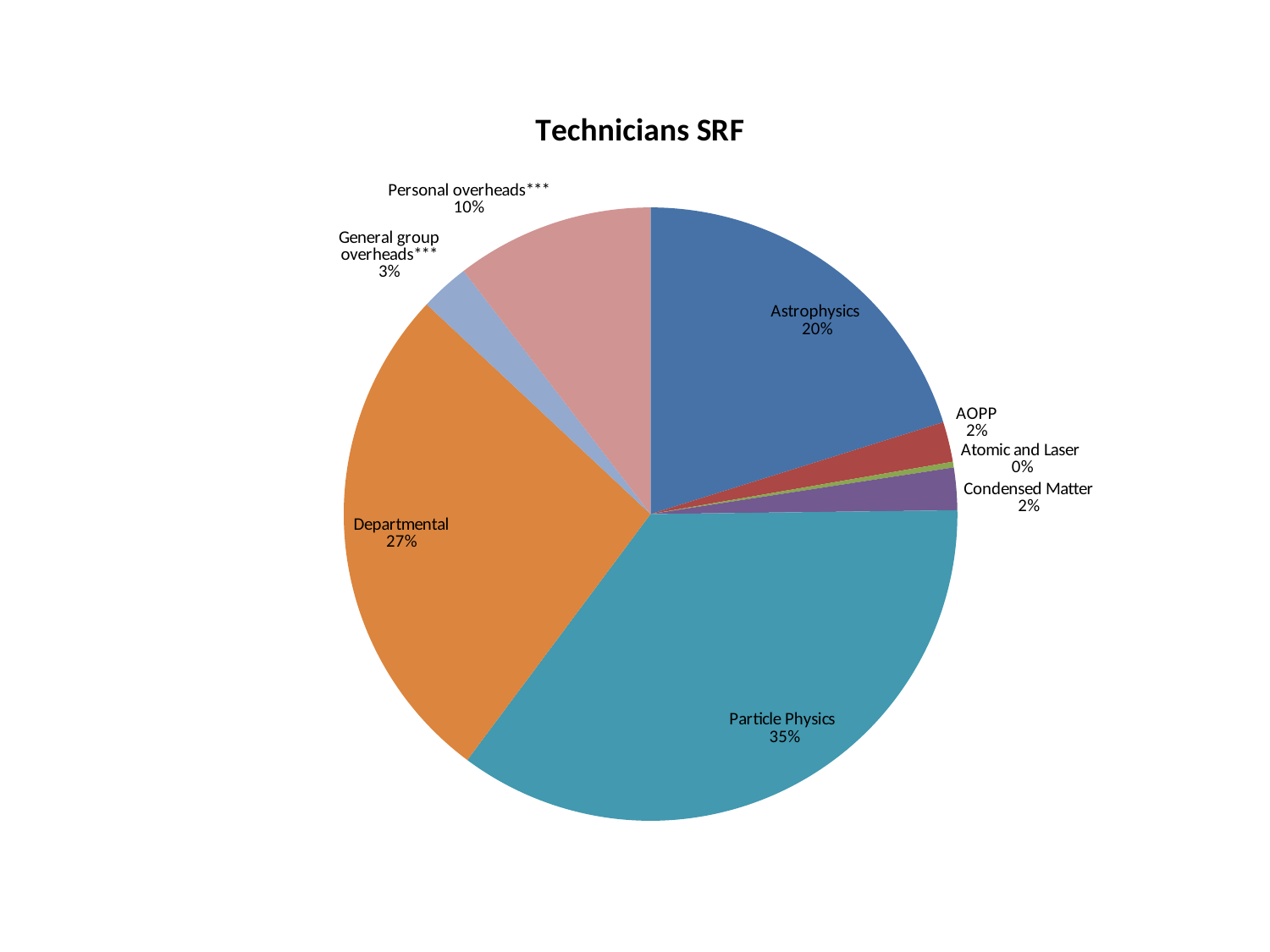
What share of the pie does Particle Physics have? 35% Which category has the largest share of the pie? Particle Physics What share of the pie does Personal overheads*** have? 10% Which category has the smallest share of the pie? Atomic and Laser What share of the pie does Astrophysics have? 20% What type of chart is shown on the slide? pie chart How many categories are shown in the pie chart? 8 What is the difference in share between Particle Physics and Departmental? 8% What is the title of the chart? Technicians SRF